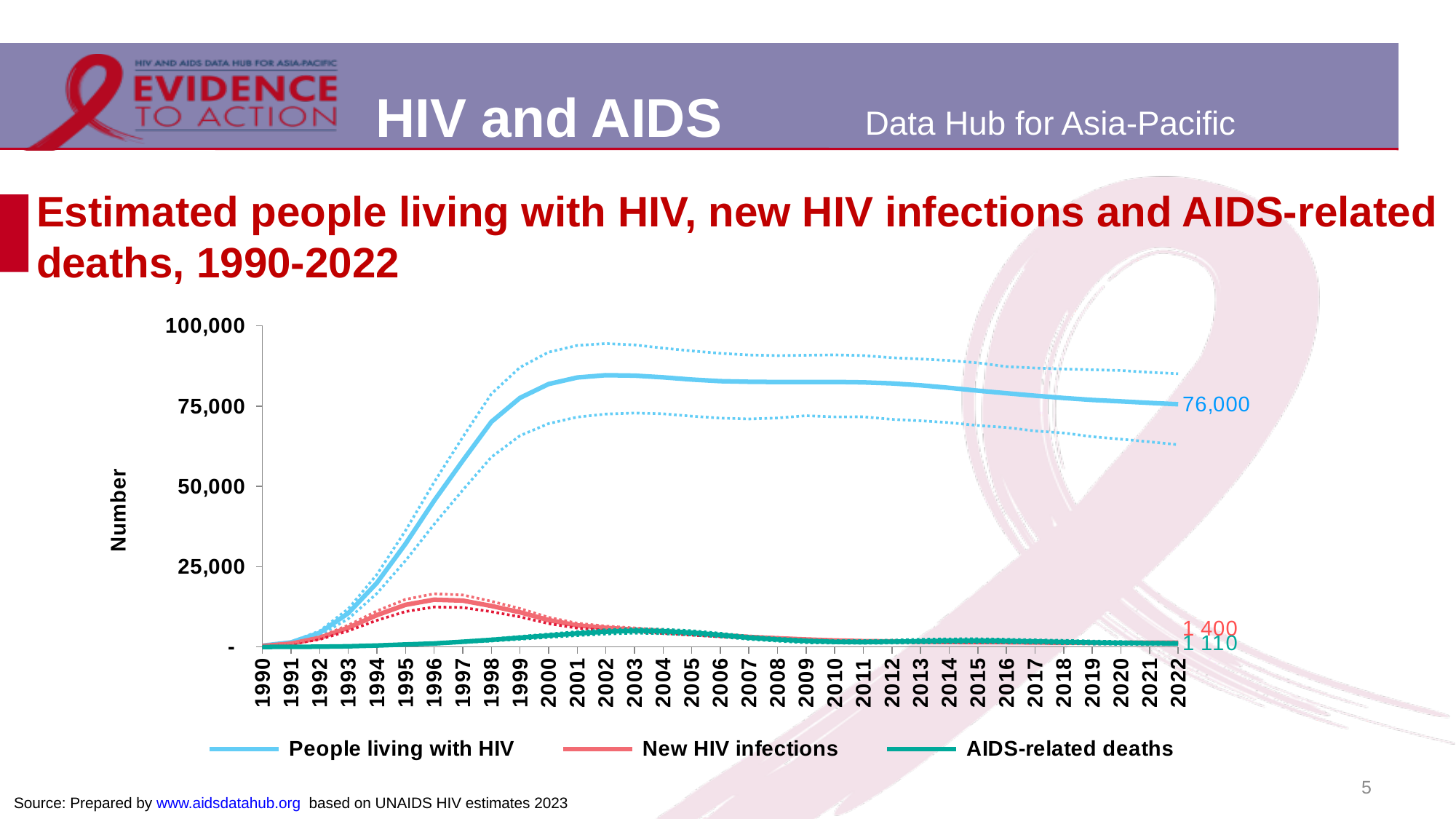
What is the labelled value for People living with HIV in 2022? 76,000 Does the People living with HIV line rise or fall between 1990 and 2002? Rise What kind of chart is shown on the slide? Line chart Which series has the highest value in 2022? People living with HIV What is the labelled value for AIDS-related deaths in 2022? 1 110 In 2022, which is larger: New HIV infections or AIDS-related deaths? New HIV infections What is the labelled value for New HIV infections in 2022? 1 400 Is the value for New HIV infections in 1996 greater or less than 25,000? less Is the value for People living with HIV in 2002 greater or less than 75,000? greater How many years are shown on the x axis? 33 How many series does the legend list? 3 In 2022, how much larger is the number of new HIV infections than the number of AIDS-related deaths? 290